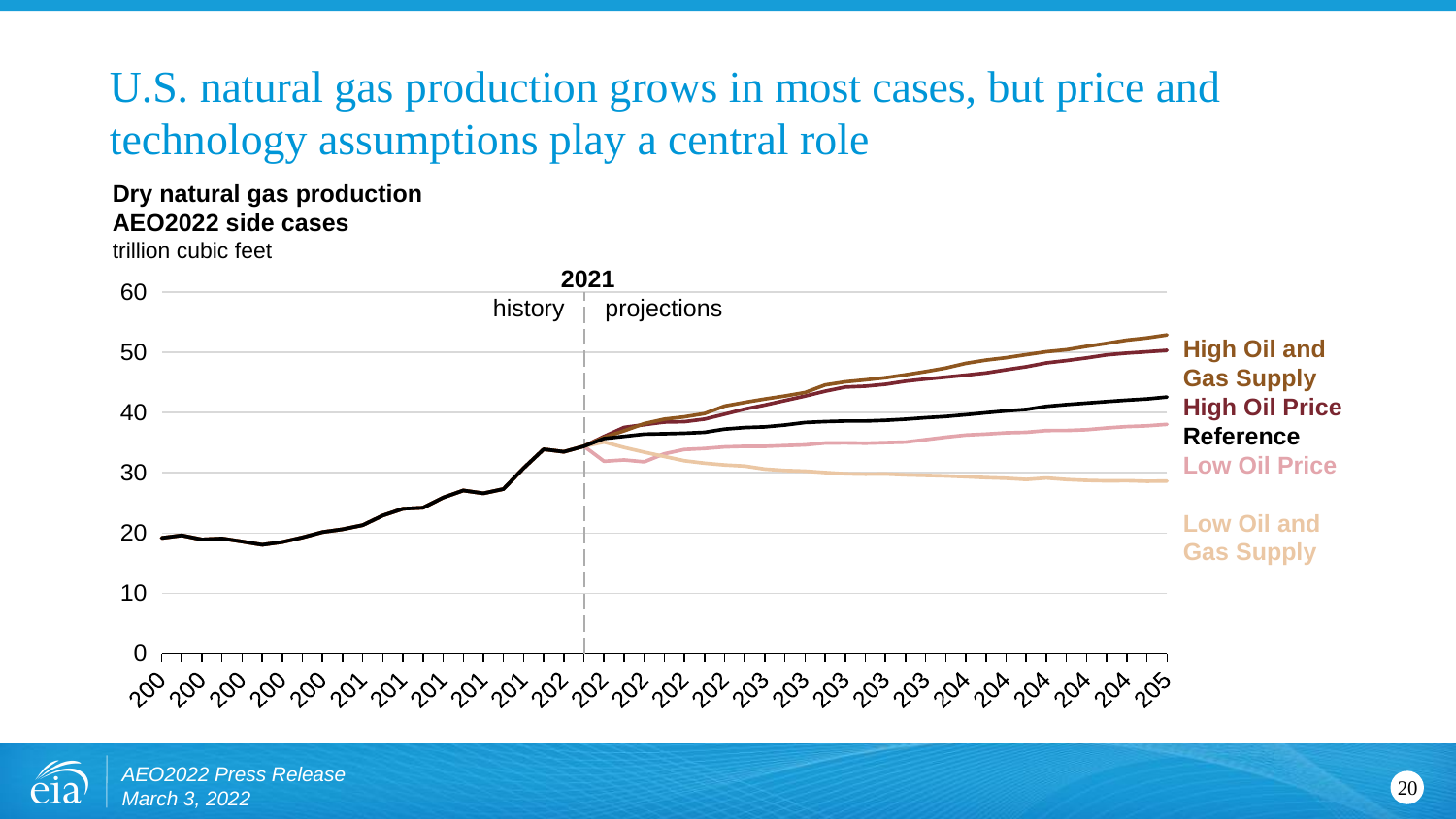
What type of chart is shown on the slide? line chart At the end of the projection period, is the value for the Reference case greater or less than 40 trillion cubic feet? greater Does the Low Oil and Gas Supply case rise or fall over the projection period? fall Does the Reference case rise or fall over the projection period? rise At the end of the projection period, is the value for the Low Oil Price case greater or less than 40 trillion cubic feet? less Which case has the lowest dry natural gas production at the end of the projection period? Low Oil and Gas Supply At the end of the projection period, is the value for the High Oil and Gas Supply case greater or less than 50 trillion cubic feet? greater How many side cases (series) are labelled on the chart? 5 Which case has the highest dry natural gas production at the end of the projection period? High Oil and Gas Supply At the end of the projection period, which is larger: the High Oil Price case or the Reference case? High Oil Price What unit is dry natural gas production measured in on the chart? trillion cubic feet